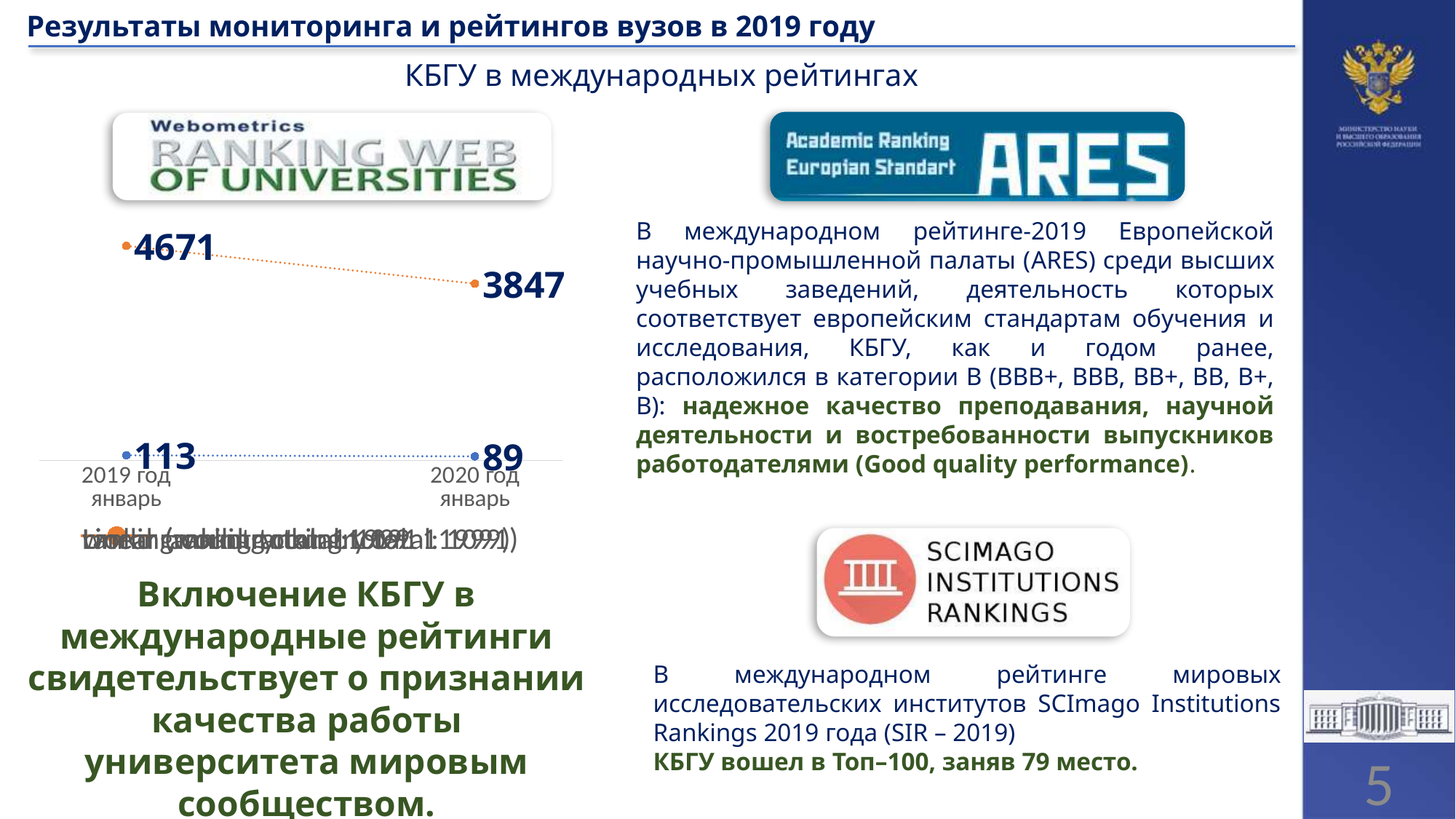
Which is larger, the orange series value for 2019 год январь or for 2020 год январь? 2019 год январь What is the value of the orange series for 2020 год январь? 3847 What is the value of the blue series for 2019 год январь? 113 By how much did the blue series change from 2019 год январь to 2020 год январь? 24 How many categories are on the x axis of the Webometrics chart? 2 How many data series are plotted in the Webometrics chart? 2 By how much did the orange series change from 2019 год январь to 2020 год январь? 824 Does the orange series rise or fall from 2019 год январь to 2020 год январь? fall What is the value of the orange series for 2019 год январь? 4671 What is the value of the blue series for 2020 год январь? 89 What kind of chart is shown under the Webometrics logo? line chart Does the blue series rise or fall from 2019 год январь to 2020 год январь? fall